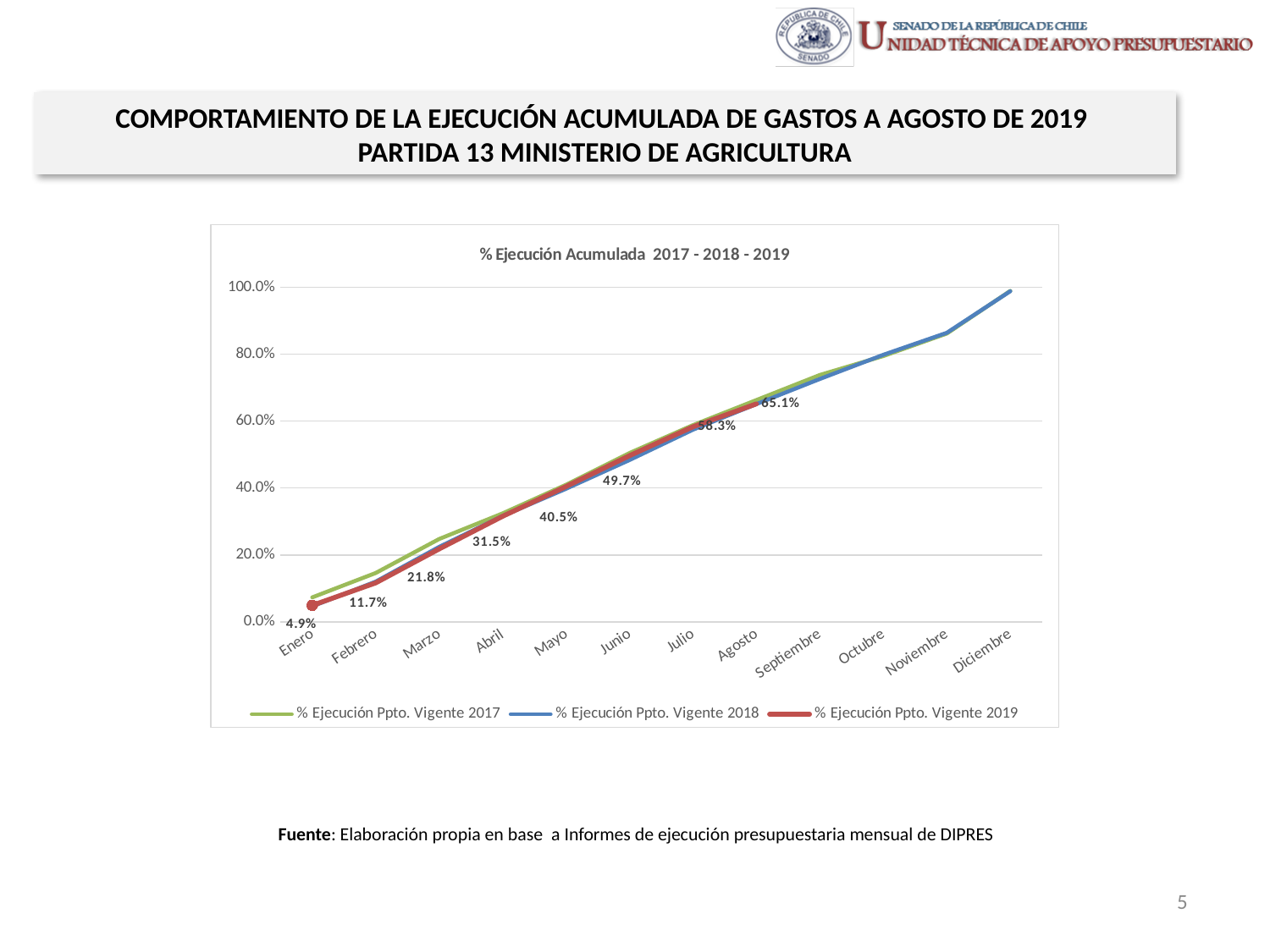
Which month has the lowest value for % Ejecución Ppto. Vigente 2019? Enero Is the value for % Ejecución Ppto. Vigente 2018 in Diciembre greater or less than 80.0%? greater What is the value for % Ejecución Ppto. Vigente 2019 in Enero? 4.9% How many months are shown on the x axis? 12 Do the values for % Ejecución Ppto. Vigente 2019 rise or fall from Enero to Agosto? rise What is the difference between the 2019 values for Agosto and Julio? 6.8 percentage points Which month has the highest value for % Ejecución Ppto. Vigente 2019? Agosto Is the value for % Ejecución Ppto. Vigente 2017 in Febrero greater or less than 20.0%? less How many series does the legend list? 3 What is the value for % Ejecución Ppto. Vigente 2019 in Agosto? 65.1% What is the value for % Ejecución Ppto. Vigente 2019 in Mayo? 40.5% What is the value for % Ejecución Ppto. Vigente 2019 in Marzo? 21.8%